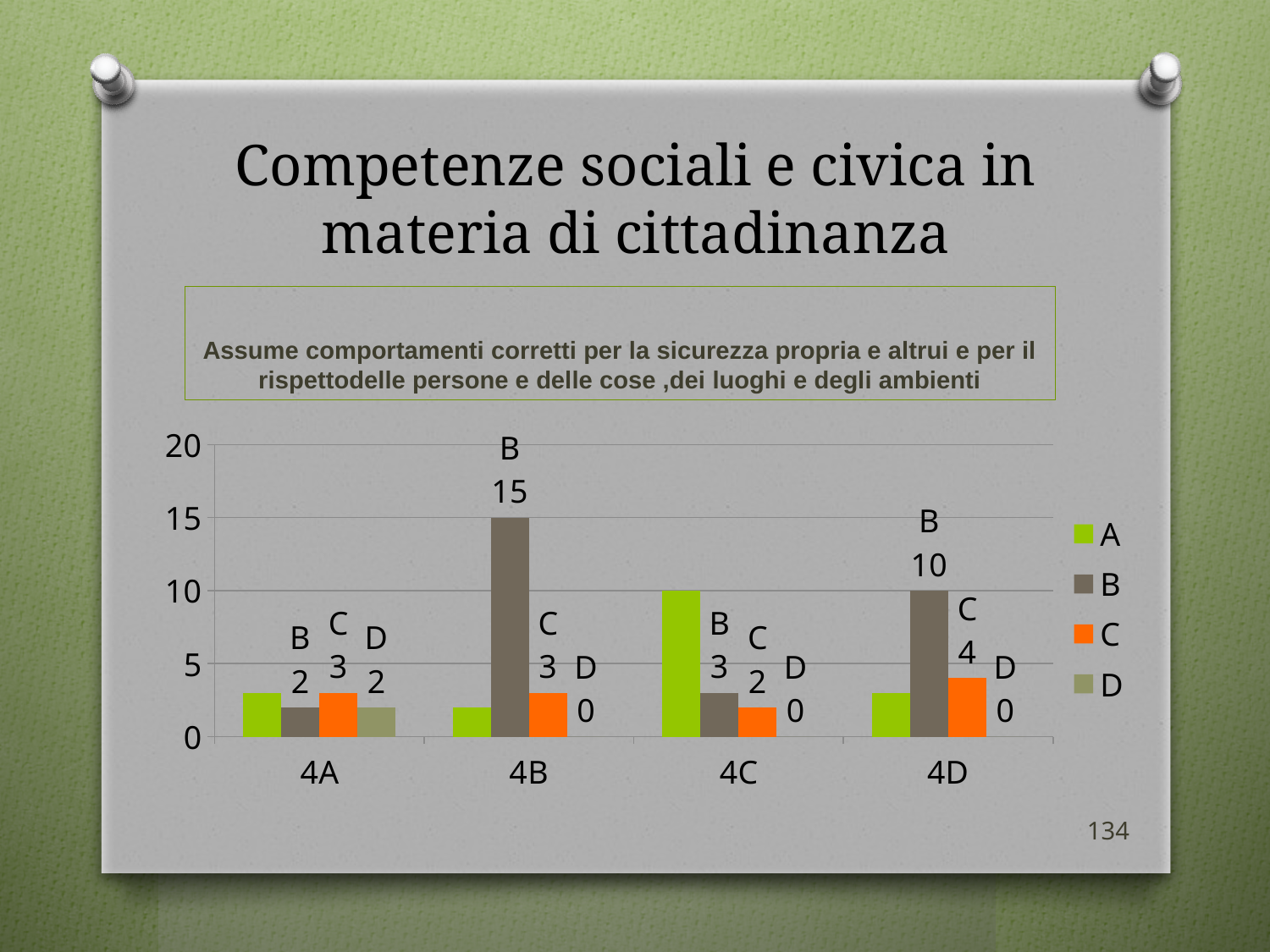
What is the value of series B for category 4B? 15 What kind of chart is shown on the slide? bar chart What is the difference between the series B values for 4B and 4D? 5 Which is larger: the series C value for 4D or the series C value for 4C? 4D How many series does the legend list? 4 Which category has the highest value for series B? 4B What is the value of series D for category 4C? 0 What is the value of series B for category 4A? 2 Which colour represents series C in the legend? orange How many categories are shown on the x axis? 4 Is the value of series A for category 4C greater or less than 5? greater What is the value of series C for category 4D? 4